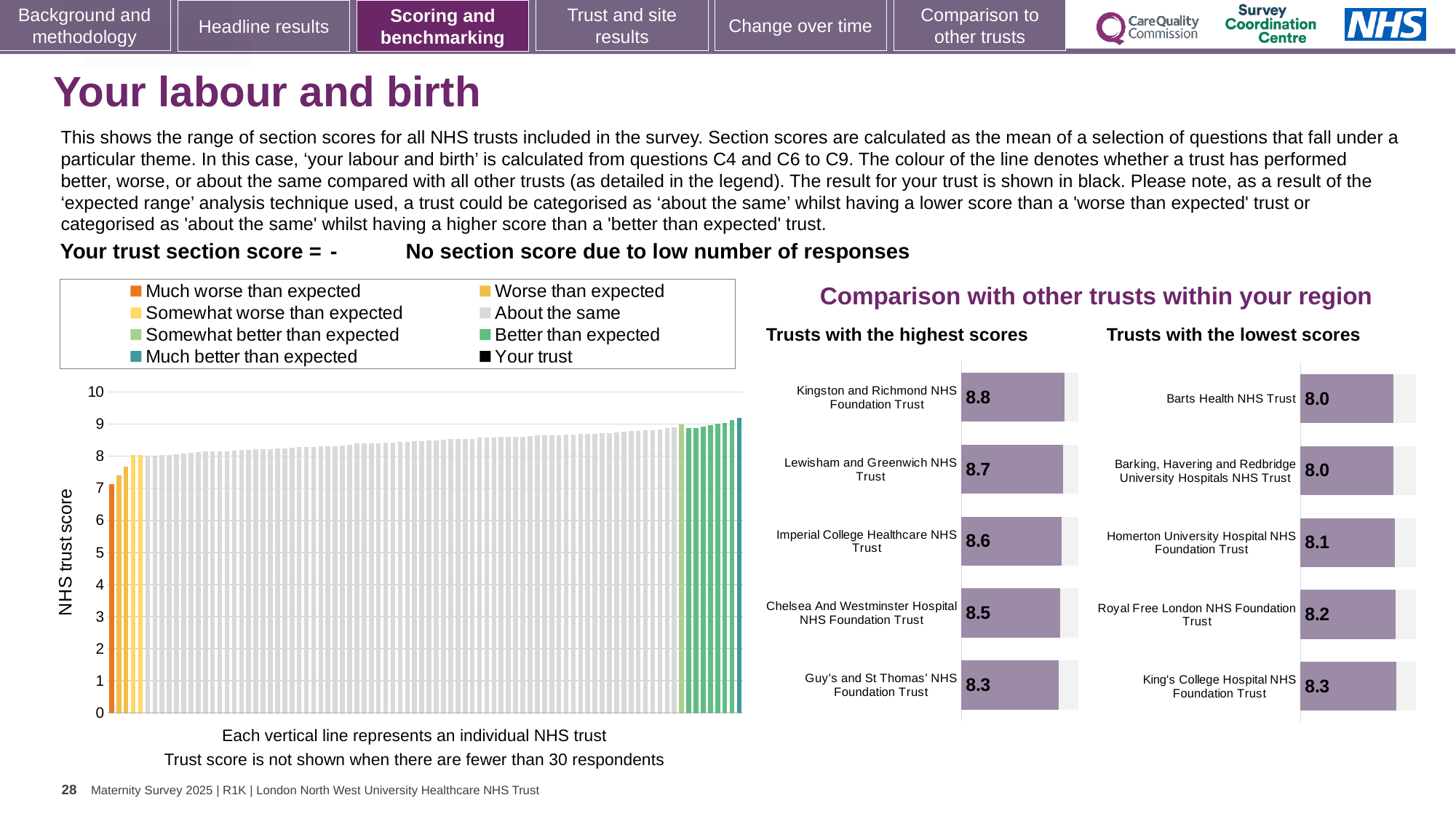
In the 'Trusts with the lowest scores' chart, which has the larger score: Royal Free London NHS Foundation Trust or Barts Health NHS Trust? Royal Free London NHS Foundation Trust In the 'Trusts with the highest scores' chart, what is the score for Imperial College Healthcare NHS Trust? 8.6 In the 'Trusts with the highest scores' chart, which trust has the lowest score? Guy's and St Thomas' NHS Foundation Trust In the 'Trusts with the highest scores' chart, what is the difference between the scores of Kingston and Richmond NHS Foundation Trust and Guy's and St Thomas' NHS Foundation Trust? 0.5 How many trusts are listed in the 'Trusts with the lowest scores' chart? 5 In the large chart on the left, do the trust scores rise or fall from left to right? rise In the 'Trusts with the lowest scores' chart, which trust has the highest score? King's College Hospital NHS Foundation Trust How many entries does the legend of the large chart on the left list? 8 In the 'Trusts with the lowest scores' chart, what is the score for Royal Free London NHS Foundation Trust? 8.2 In the 'Trusts with the highest scores' chart, which trust has the highest score? Kingston and Richmond NHS Foundation Trust In the 'Trusts with the highest scores' chart, what is the score for Kingston and Richmond NHS Foundation Trust? 8.8 In the 'Trusts with the lowest scores' chart, what is the score for Homerton University Hospital NHS Foundation Trust? 8.1